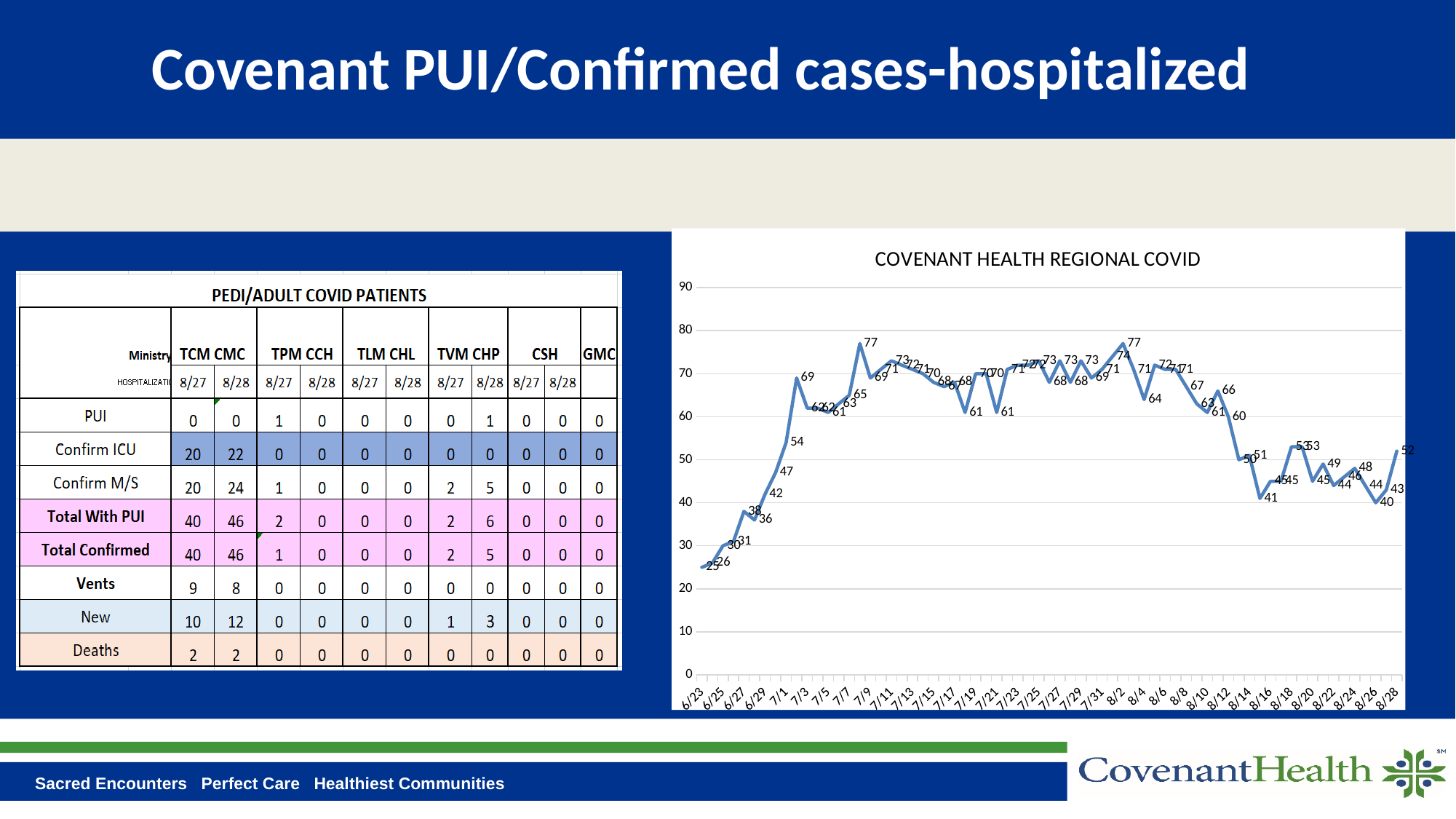
In the COVENANT HEALTH REGIONAL COVID chart, what is the highest value plotted on the line? 77 In the COVENANT HEALTH REGIONAL COVID chart, what is the difference between the highest and lowest values on the line? 52 In the COVENANT HEALTH REGIONAL COVID chart, what is the highest value shown on the y axis? 90 What kind of chart is the COVENANT HEALTH REGIONAL COVID chart? line chart In the COVENANT HEALTH REGIONAL COVID chart, do the values rise or fall between 6/23 and 7/9? rise What is the title of the chart on the right side of the slide? COVENANT HEALTH REGIONAL COVID In the COVENANT HEALTH REGIONAL COVID chart, what is the value on 6/23, the first date on the x axis? 25 In the COVENANT HEALTH REGIONAL COVID chart, what is the lowest value plotted on the line? 25 In the COVENANT HEALTH REGIONAL COVID chart, which is larger: the value on 6/23 or the value on 8/28? 8/28 In the COVENANT HEALTH REGIONAL COVID chart, is the value on 8/28 greater or less than 50? greater In the COVENANT HEALTH REGIONAL COVID chart, what is the difference between the value on 8/28 and the value on 6/23? 27 In the COVENANT HEALTH REGIONAL COVID chart, what is the value on 8/28, the last date on the x axis? 52